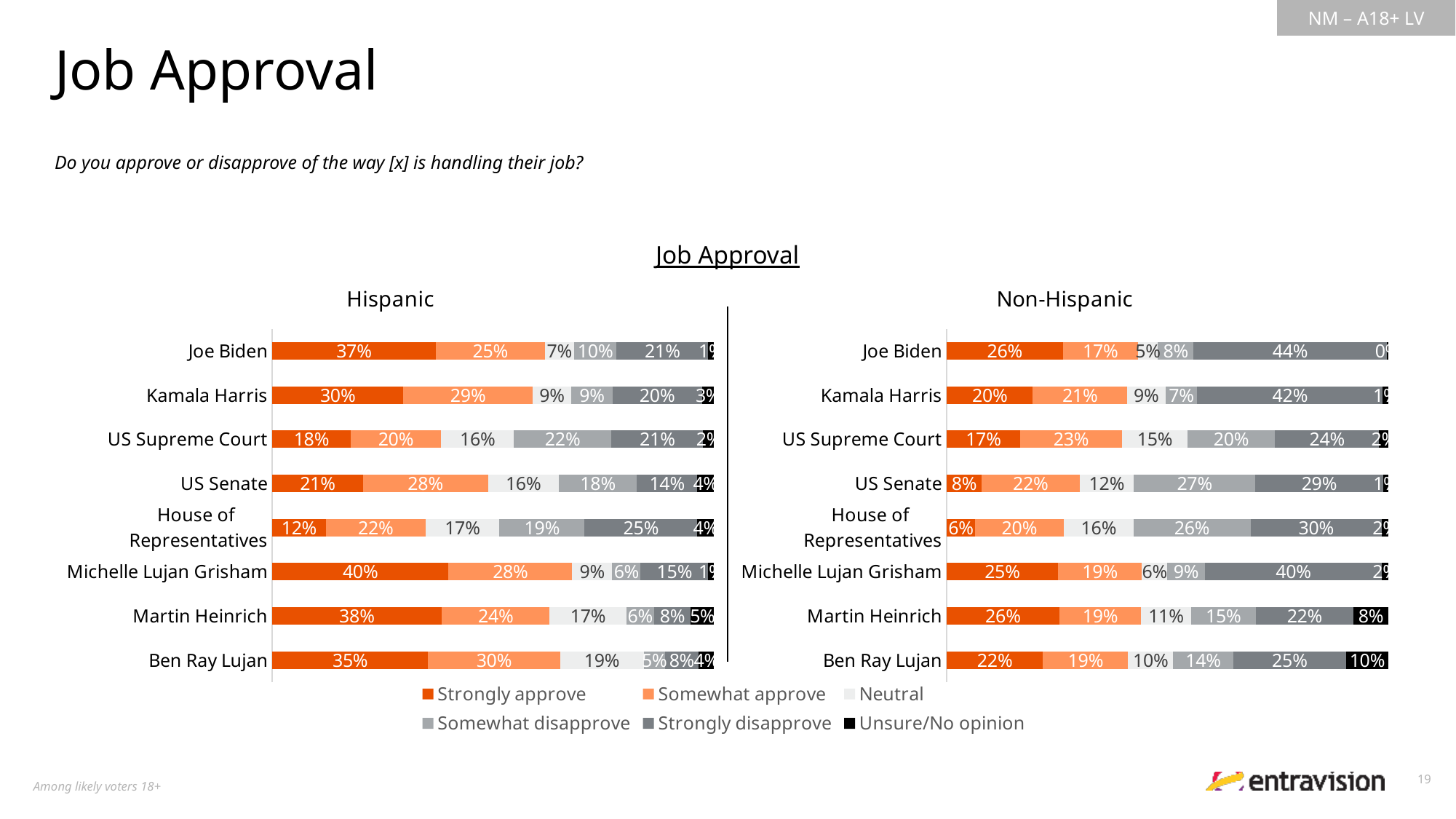
In the Hispanic chart, what is the Somewhat approve value for Kamala Harris? 29% In the Non-Hispanic chart, which is larger: the Strongly disapprove value for Kamala Harris or for Michelle Lujan Grisham? Kamala Harris In the Hispanic chart, what is the difference between the Strongly approve values for Martin Heinrich and Ben Ray Lujan? 3% In the Hispanic chart, which category has the highest Strongly approve value? Michelle Lujan Grisham What kind of chart is used for the Hispanic and Non-Hispanic data? Stacked bar chart In the Hispanic chart, what is the Strongly approve value for Michelle Lujan Grisham? 40% How many categories are shown in the Hispanic chart? 8 In the Non-Hispanic chart, which category has the lowest Strongly approve value? House of Representatives In the Non-Hispanic chart, what is the Unsure/No opinion value for Ben Ray Lujan? 10% In the Non-Hispanic chart, what is the Strongly disapprove value for Joe Biden? 44% How many series does the legend list? 6 What is the title shown above the two charts? Job Approval